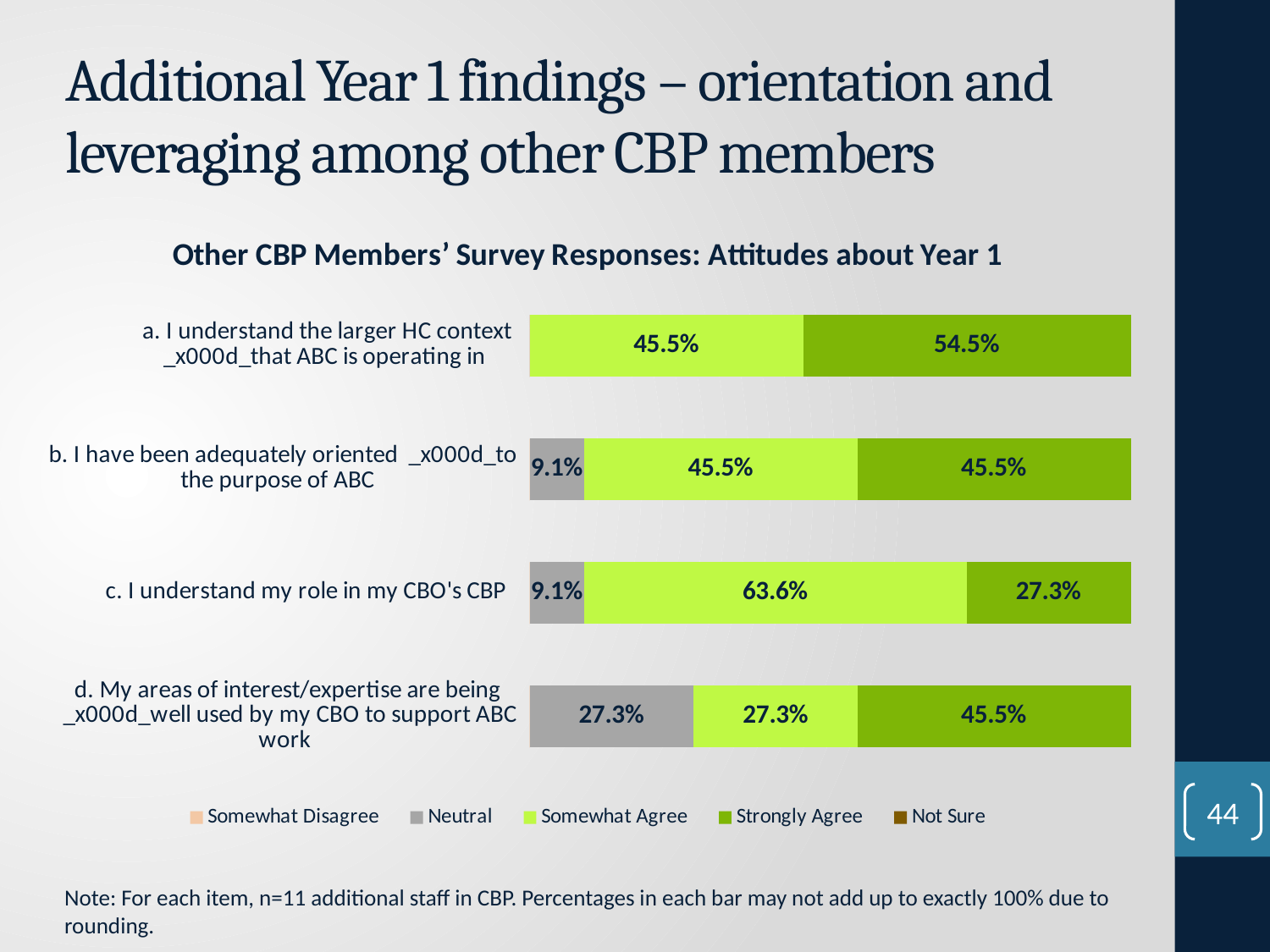
Which is larger: the Strongly Agree percentage for item a or the Strongly Agree percentage for item c? Item a (54.5%) What is the Somewhat Agree percentage for item c, 'I understand my role in my CBO's CBP'? 63.6% What is the Neutral percentage for item b, 'I have been adequately oriented to the purpose of ABC'? 9.1% How many survey items (bars) are shown in the chart? 4 What is the difference between the Somewhat Agree percentage for item c and the Somewhat Agree percentage for item d? 36.3% Which item has the lowest Strongly Agree percentage? c. I understand my role in my CBO's CBP What is the Strongly Agree percentage for item a, 'I understand the larger HC context that ABC is operating in'? 54.5% What is the title of the chart? Other CBP Members' Survey Responses: Attitudes about Year 1 Which item has the highest Strongly Agree percentage? a. I understand the larger HC context that ABC is operating in How many series does the legend list? 5 What is the Neutral percentage for item d, 'My areas of interest/expertise are being well used by my CBO to support ABC work'? 27.3% What kind of chart is shown on the slide? Stacked bar chart